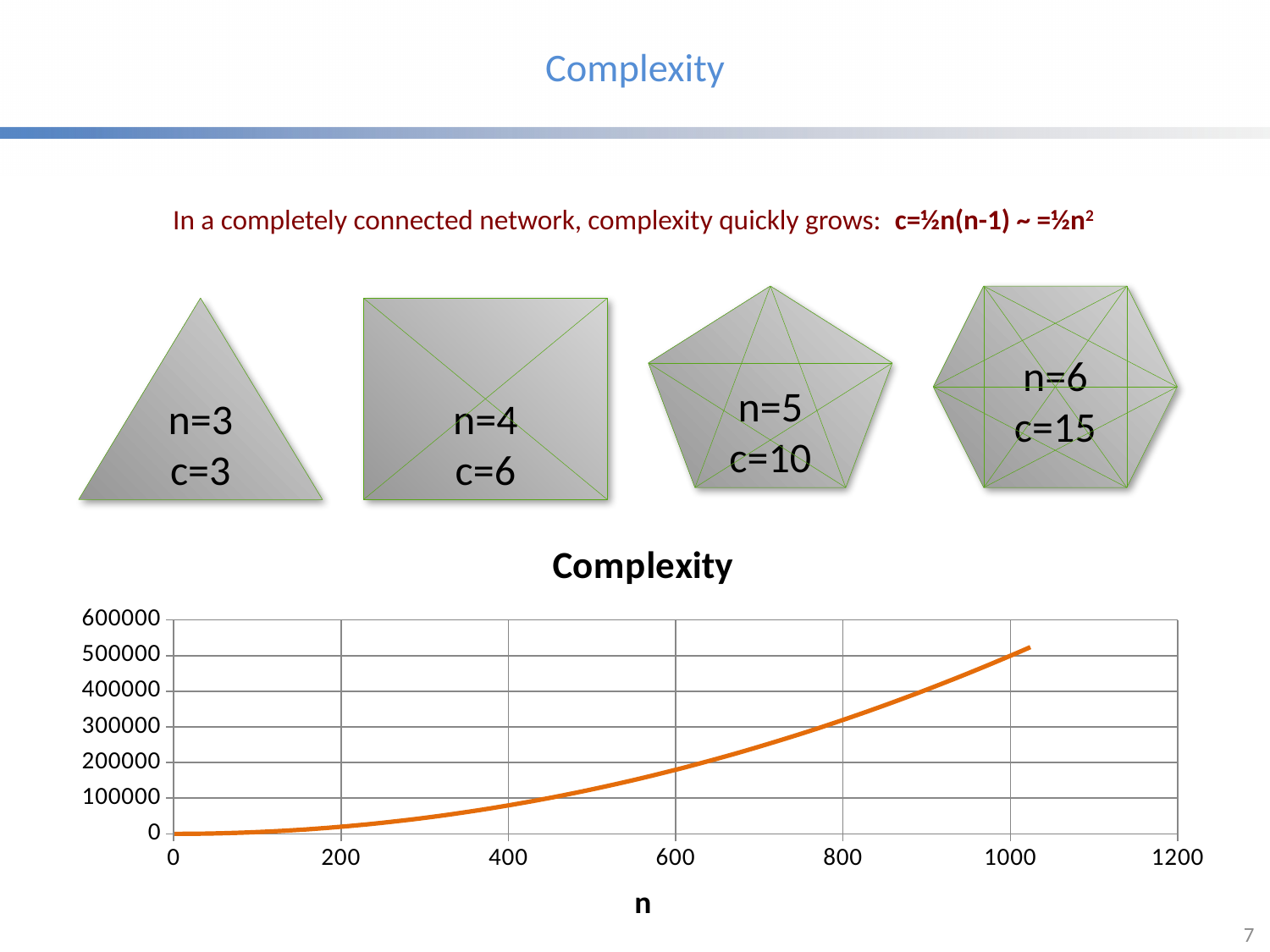
Is the value for n=200 greater or less than 100000? less Is the value for n=400 greater or less than 100000? less Is the value for n=600 greater or less than 100000? greater What is the title of the chart? Complexity What is the label on the x axis of the chart? n Which is larger, the value at n=400 or the value at n=800? n=800 What kind of chart is shown on the slide? line chart Do the values on the chart rise or fall as n increases? rise